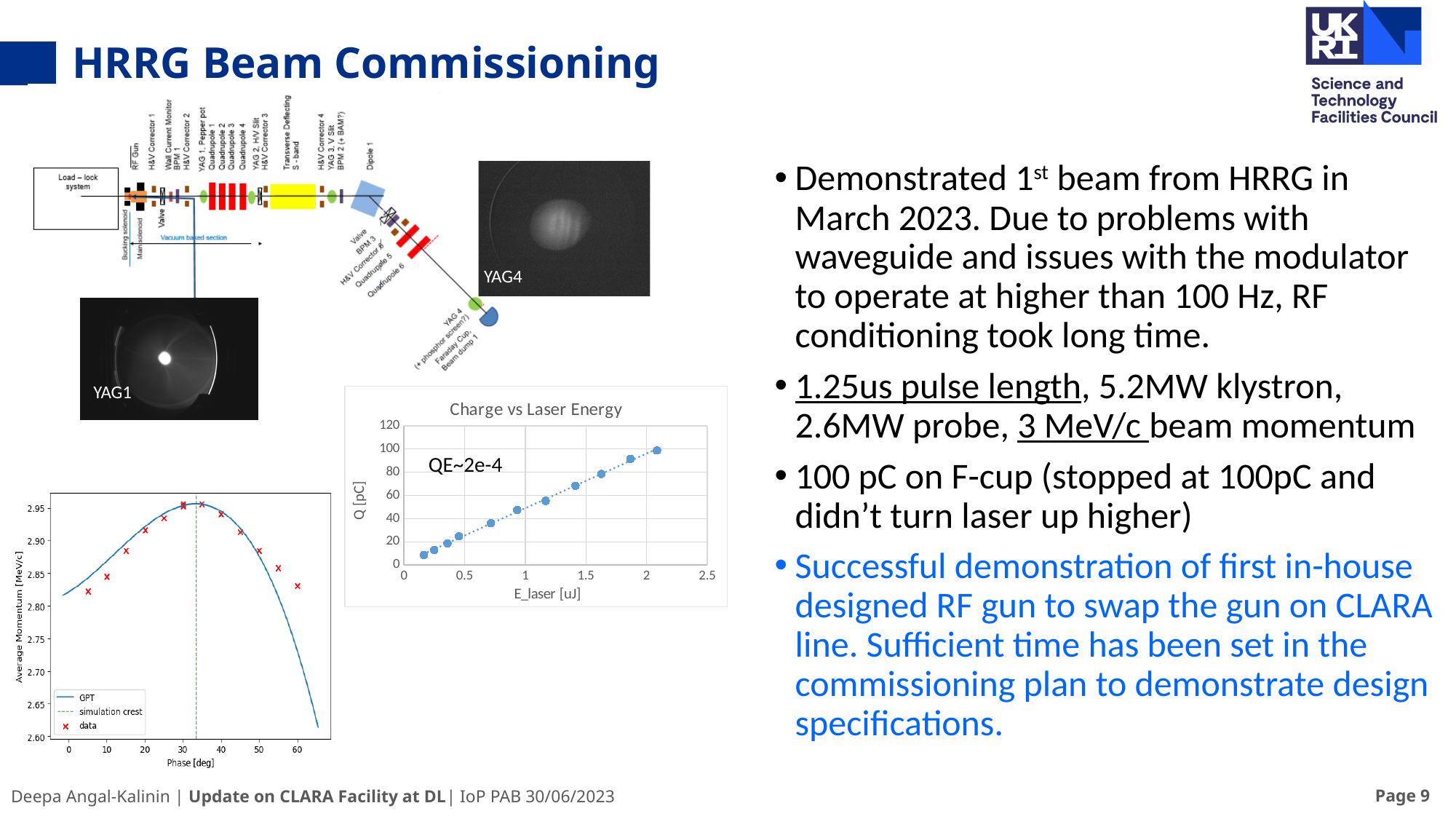
In the bottom-left chart, is the data point at a phase of 5 degrees greater or less than 2.85 MeV/c? less In the Charge vs Laser Energy chart, what is the maximum value shown on the y axis? 120 In the Charge vs Laser Energy chart, does the charge rise or fall as laser energy increases? rise What kind of chart is the Charge vs Laser Energy chart? scatter chart In the Charge vs Laser Energy chart, is the charge at the highest laser energy plotted greater or less than 80 pC? greater In the bottom-left chart, is the data point at a phase of 30 degrees greater or less than 2.90 MeV/c? greater In the Charge vs Laser Energy chart, what is the label of the x axis? E_laser [uJ] In the bottom-left chart, does the GPT curve rise or fall between a phase of 40 and 60 degrees? fall What is the title of the chart in the centre of the slide? Charge vs Laser Energy How many entries does the legend of the phase chart at the bottom left list? 3